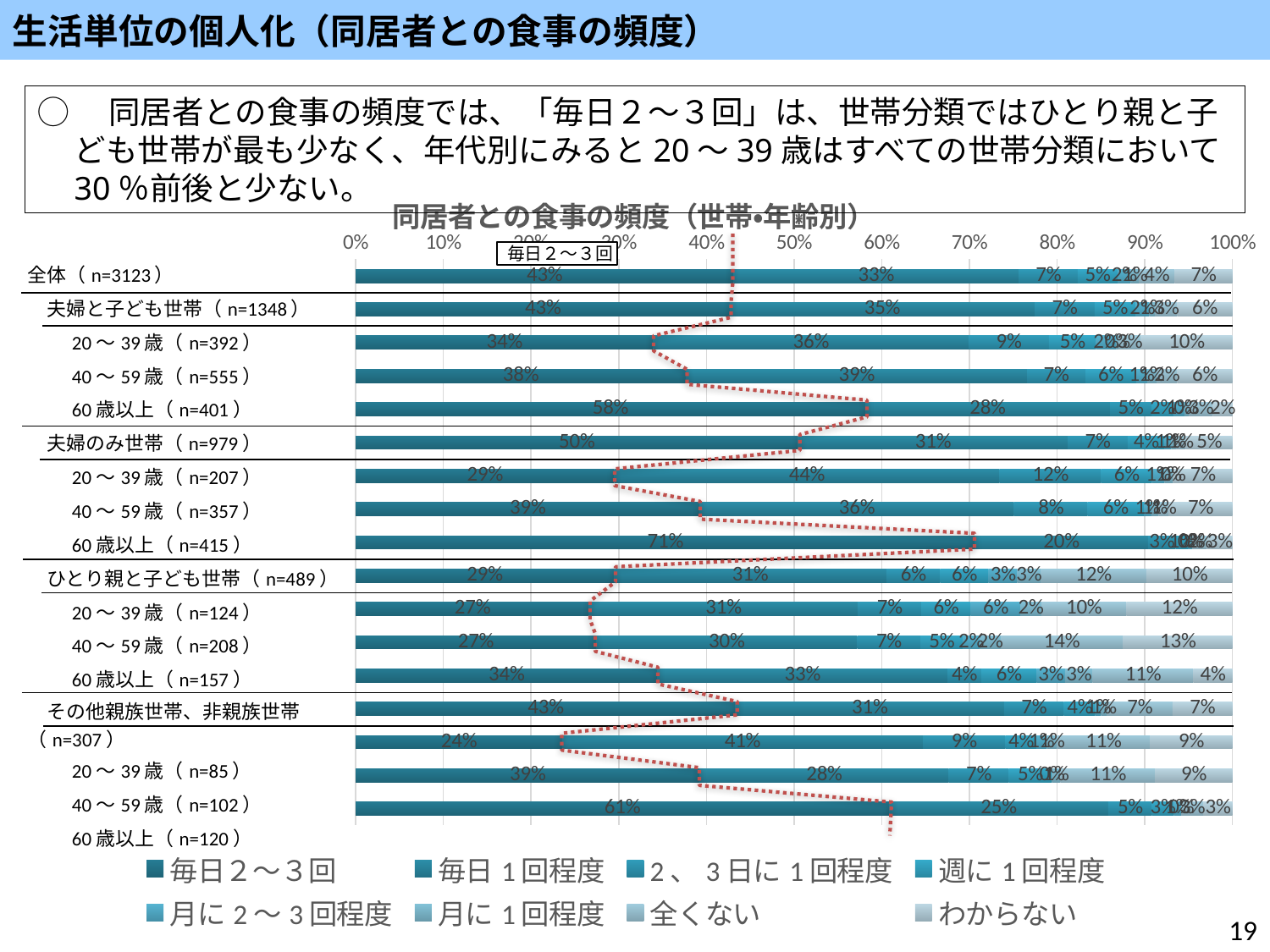
How many series does the legend list? 8 What is the value of 毎日１回程度 for 夫婦のみ世帯 20～39歳 (n=207)? 44% What is the value of 毎日２～３回 for 夫婦のみ世帯 60歳以上 (n=415)? 71% Which category has the highest value for 毎日２～３回? 夫婦のみ世帯 60歳以上 (n=415) Which has the larger value for 毎日２～３回: 夫婦のみ世帯 20～39歳 (n=207) or 夫婦のみ世帯 40～59歳 (n=357)? 夫婦のみ世帯 40～59歳 (n=357) What is the value of 毎日１回程度 for 夫婦と子ども世帯 (n=1348)? 35% What is the title of the chart? 同居者との食事の頻度（世帯・年齢別） What is the value of 毎日１回程度 for 全体 (n=3123)? 33% What kind of chart is shown on the slide? Stacked horizontal bar chart What is the value of 毎日２～３回 for 全体 (n=3123)? 43% What is the difference in 毎日２～３回 between 夫婦と子ども世帯 60歳以上 (n=401) and 夫婦と子ども世帯 20～39歳 (n=392)? 24 percentage points What is the value of 毎日２～３回 for ひとり親と子ども世帯 (n=489)? 29%